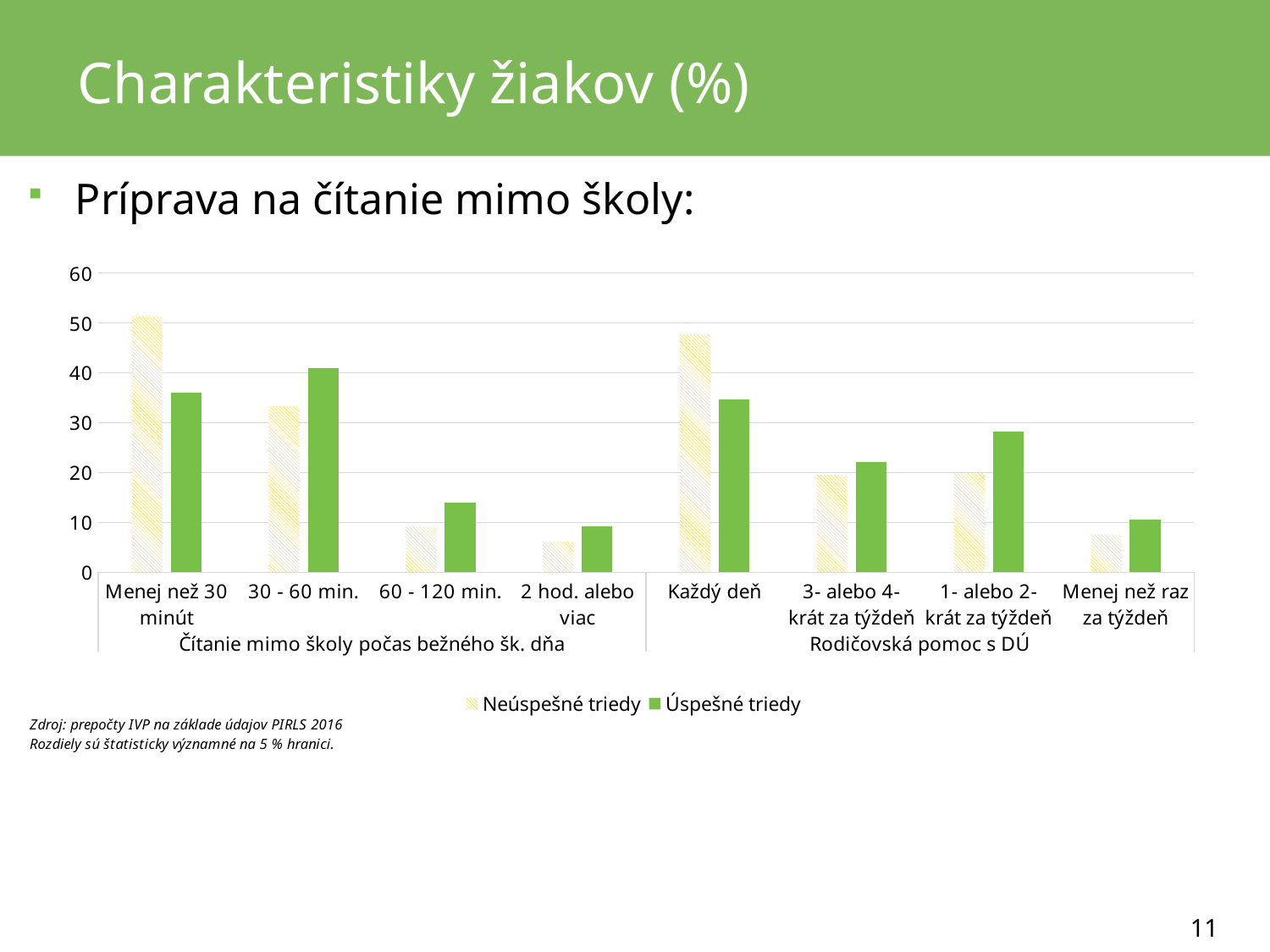
Which category has the highest value for the Neúspešné triedy series? Menej než 30 minút Across the four categories of 'Čítanie mimo školy počas bežného šk. dňa', do the Neúspešné triedy values rise or fall from left to right? fall Within the group 'Čítanie mimo školy počas bežného šk. dňa', which category has the lowest value for Neúspešné triedy? 2 hod. alebo viac In the category 'Menej než 30 minút', which series has the larger value, Neúspešné triedy or Úspešné triedy? Neúspešné triedy In the category '30 - 60 min.', which series has the larger value, Neúspešné triedy or Úspešné triedy? Úspešné triedy What kind of chart is shown on the slide? bar chart Which category has the highest value for the Úspešné triedy series? 30 - 60 min. Is the value for Úspešné triedy in the category 'Každý deň' greater or less than 40? less How many categories are shown along the x axis of the chart? 8 Is the value for Neúspešné triedy in the category 'Menej než 30 minút' greater or less than 40? greater In the category '1- alebo 2-krát za týždeň', which series has the larger value, Neúspešné triedy or Úspešné triedy? Úspešné triedy How many series does the legend list? 2